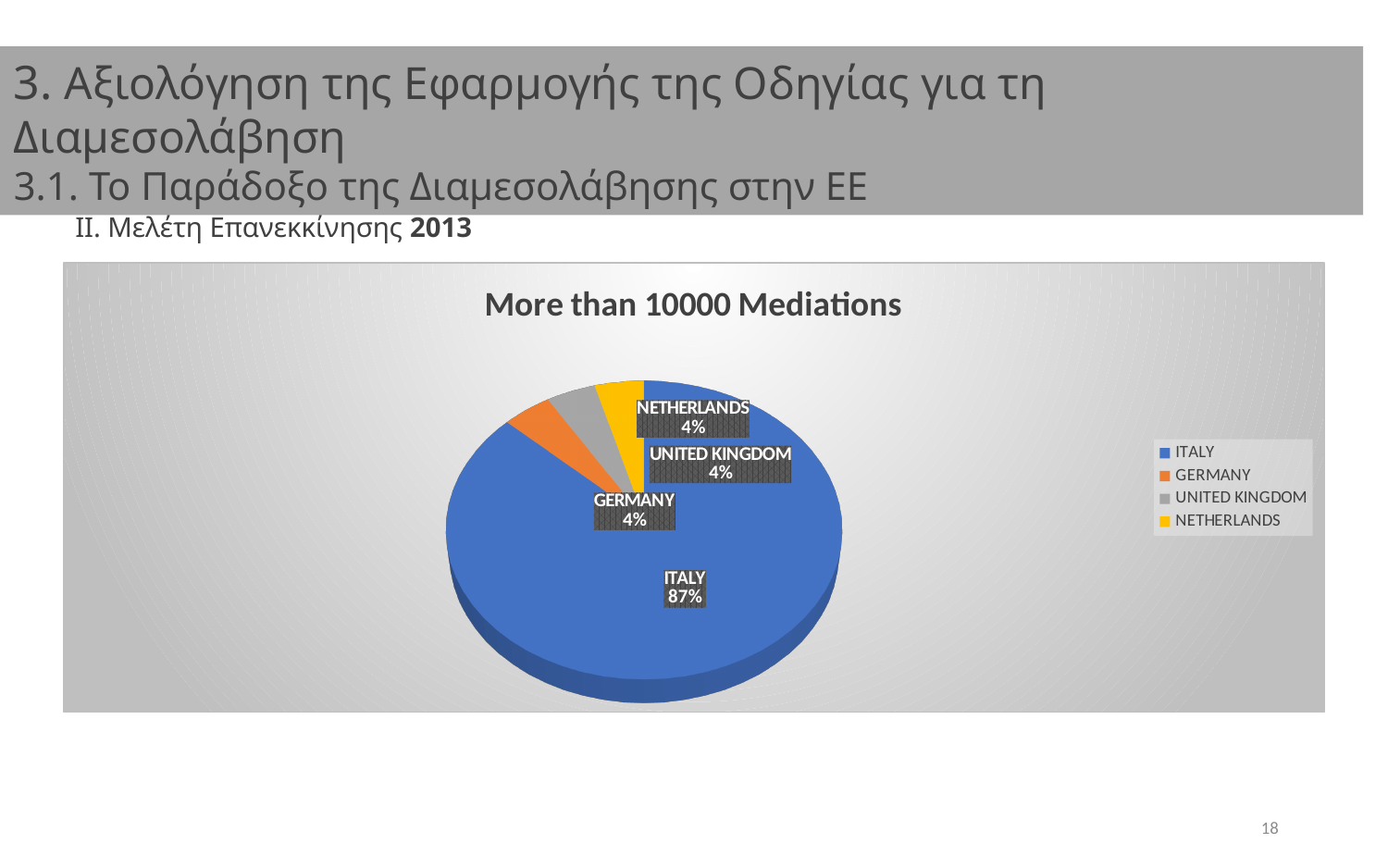
How many entries does the legend list? 4 What kind of chart is shown on the slide? pie chart Which country has the largest slice of the pie? Italy What share of the pie does the United Kingdom hold? 4% How many slices does the pie chart have? 4 Which colour represents Italy in the pie chart? blue What share of the pie does Germany hold? 4% Which is larger, the share for Italy or the share for the Netherlands? Italy What share of the pie does Italy hold? 87% What share of the pie does the Netherlands hold? 4% What is the title of the chart? More than 10000 Mediations What is the difference between Italy's share and Germany's share? 83%